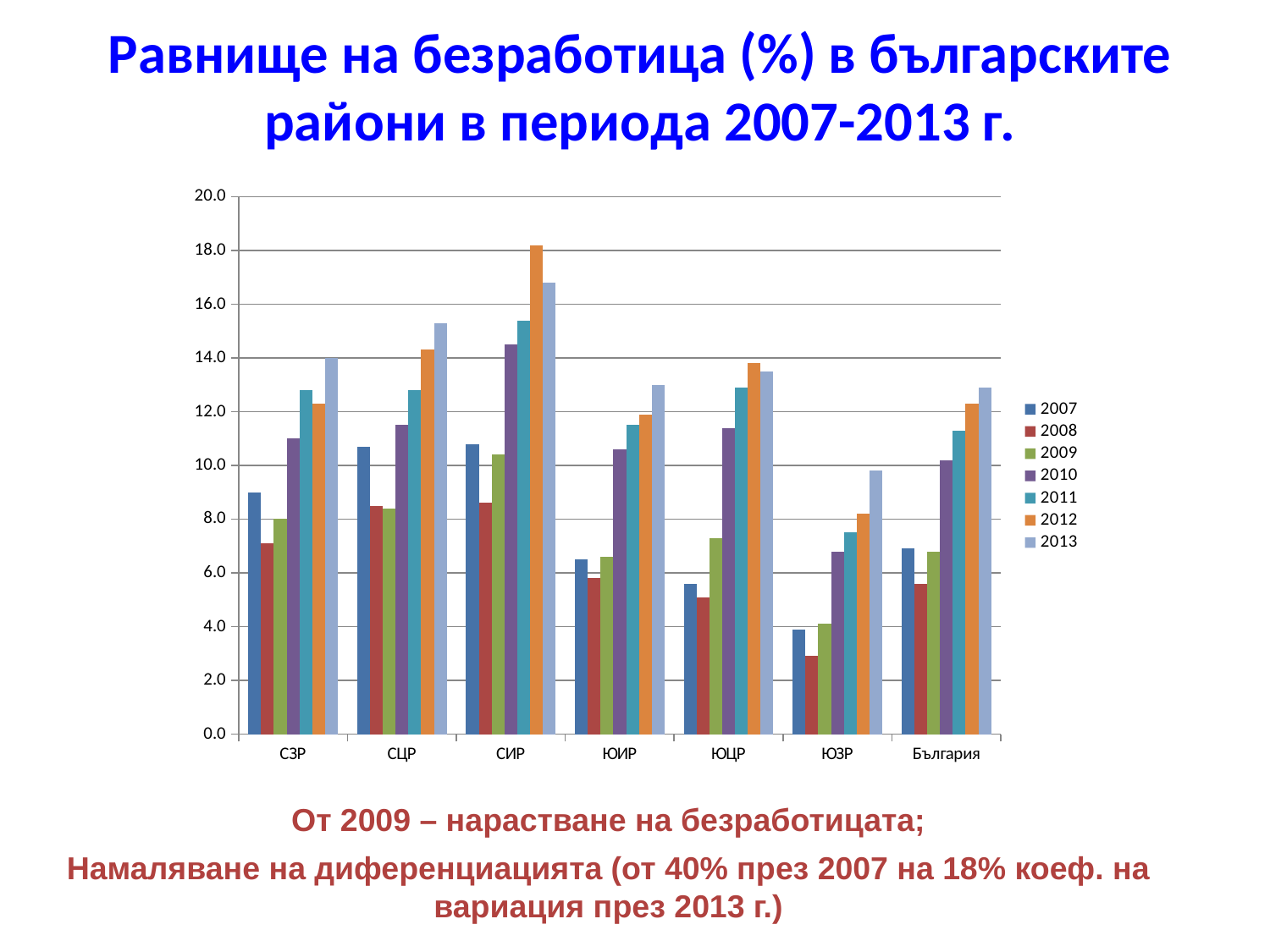
What kind of chart is shown on the slide? bar chart How many regions (categories) are shown on the x axis? 7 Which region has the lowest unemployment rate for 2008? ЮЗР Which region has the highest unemployment rate for 2012? СИР How many series does the legend list? 7 For ЮЗР, do the values rise or fall from 2009 to 2013? rise Is the value for България in 2013 greater or less than 12? greater Is the value for СИР in 2012 greater or less than 16? greater Which is larger: the 2013 value for ЮИР or the 2013 value for ЮЗР? ЮИР Which year has the highest value for СЦР? 2013 Is the value for ЮЗР in 2008 greater or less than 4? less Which region has the lowest value for 2013? ЮЗР